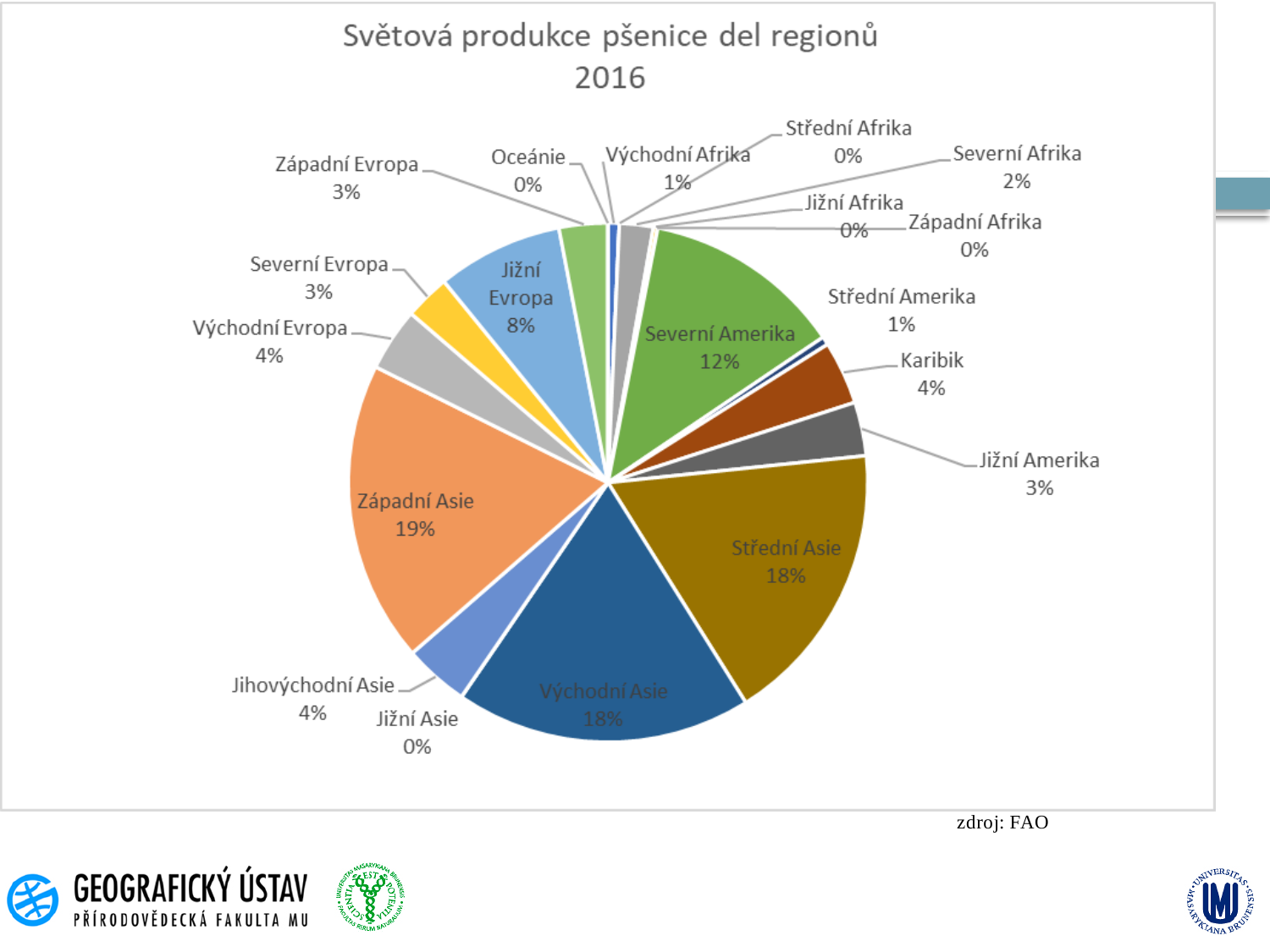
What share does Severní Amerika have in the pie chart? 12% What share of world wheat production does Západní Asie have? 19% What share does Jižní Evropa have? 8% Which has a larger share, Karibik or Jižní Amerika? Karibik Which region has the largest share in the pie chart? Západní Asie How many regions are shown in the pie chart? 19 What kind of chart is shown on the slide? pie chart What is the title of the chart? Světová produkce pšenice del regionů 2016 Which has a larger share, Jižní Evropa or Východní Evropa? Jižní Evropa What is the combined share of Východní Asie and Střední Asie? 36% What share does Severní Afrika have? 2% What is the difference between the shares of Západní Asie and Severní Amerika? 7%